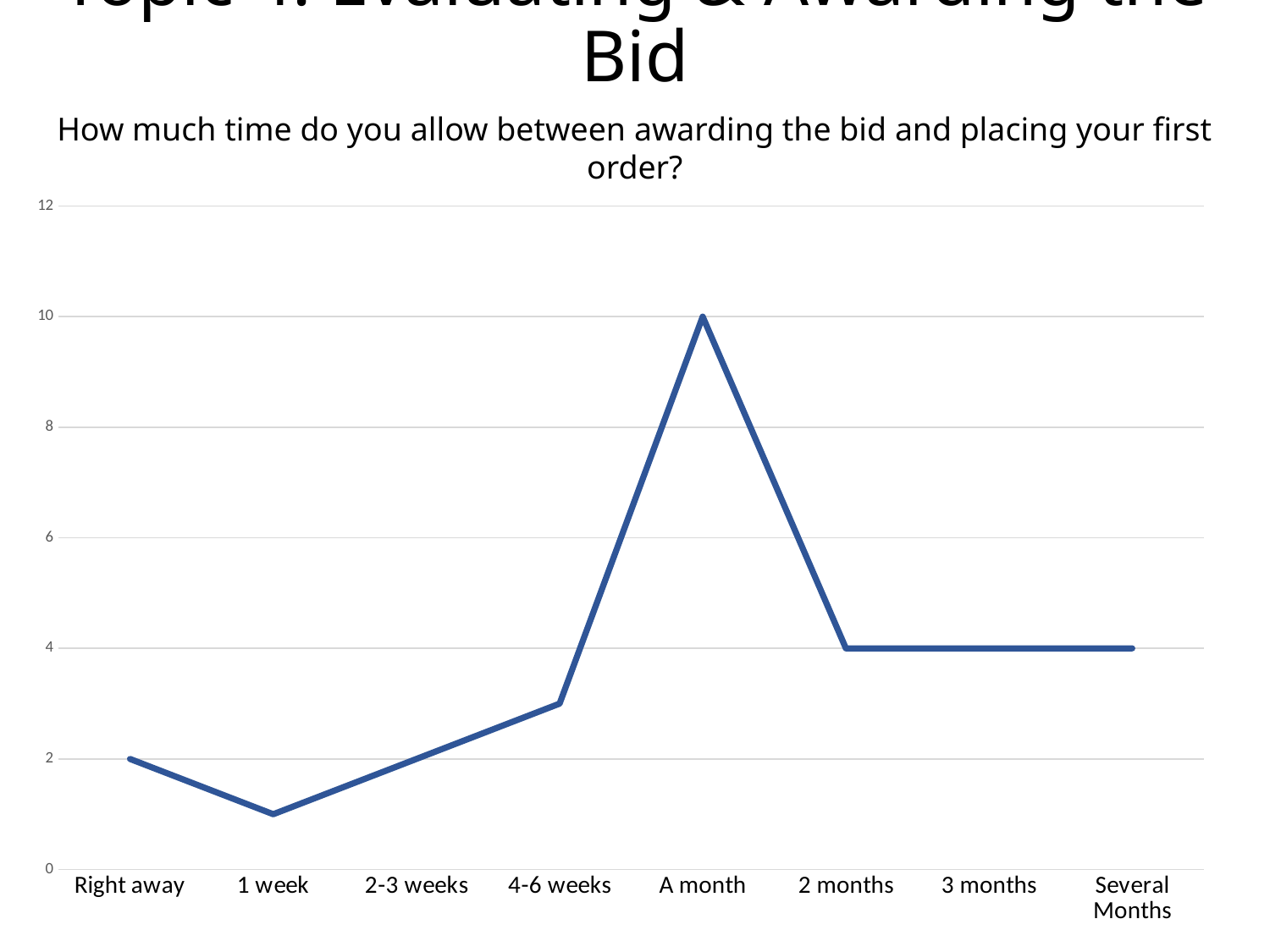
Is the value for 1 week greater or less than 2? less What is the difference between the value for A month and the value for Right away? 8 What is the value for Several Months? 4 What kind of chart is shown on the slide? line chart What is the value for A month? 10 Which category has the highest value? A month Which category has the lowest value? 1 week Does the line rise or fall from A month to 2 months? fall Which is larger, the value for A month or the value for 2 months? A month How many categories are shown on the x axis? 8 What is the value for Right away? 2 What is the title of the chart? How much time do you allow between awarding the bid and placing your first order?